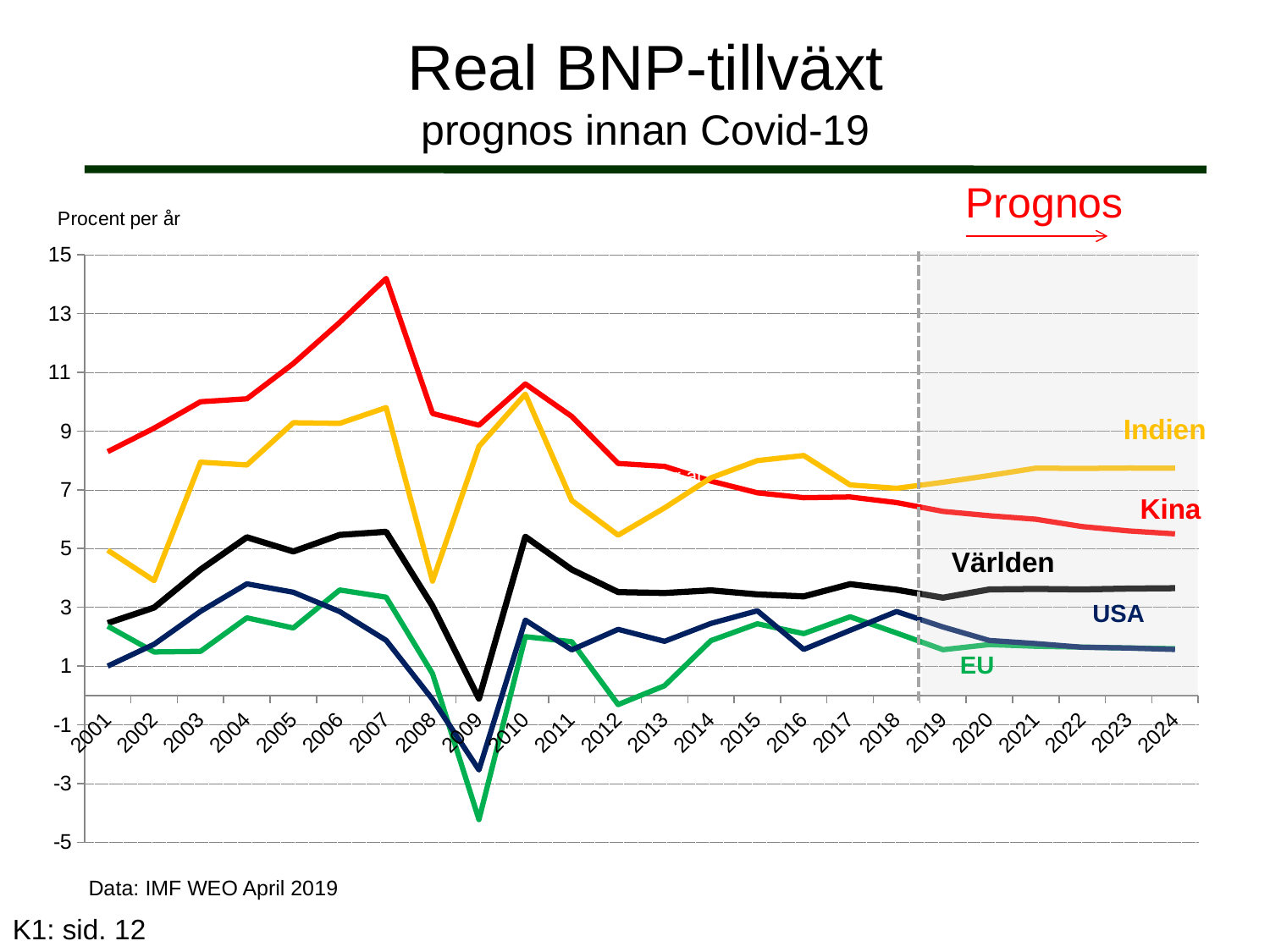
How many years are shown on the x axis of the chart? 24 What kind of chart is shown on the slide? line chart In which year does the Kina line reach its highest value? 2007 How many series are plotted in the chart? 5 In which year does the EU line reach its lowest value? 2009 Is the value for Kina in 2024 greater or less than 7? less What does the shaded area on the right of the chart represent? Prognos Is the value for Kina in 2007 greater or less than 13? greater Is the value for EU in 2009 greater or less than -3? less Which is larger in 2024, the value for Indien or the value for Kina? Indien Which series has the highest value in 2007? Kina Does the Kina line rise or fall from 2010 to 2024? fall